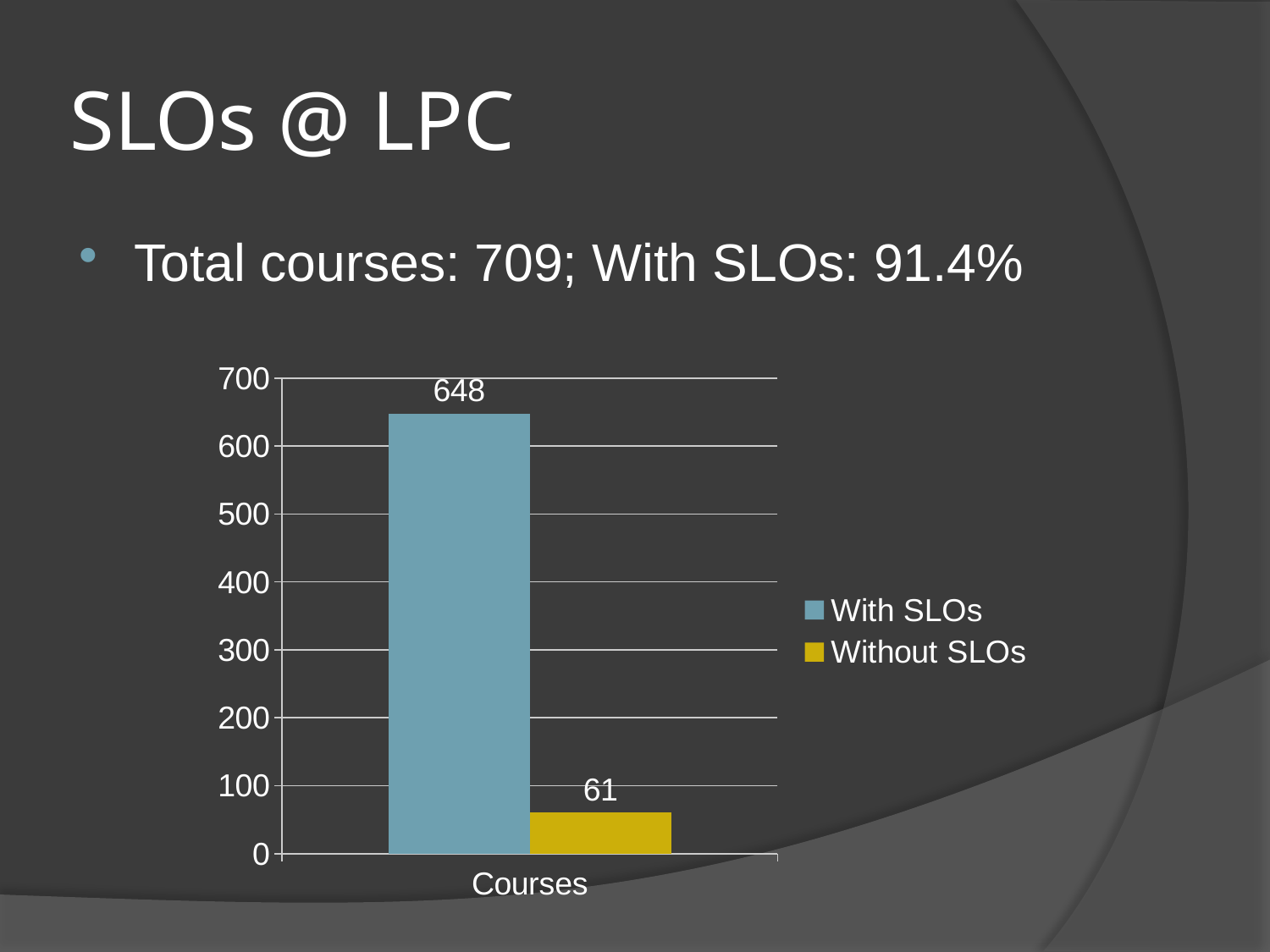
Which series has the lowest value on the chart? Without SLOs Is the value for With SLOs greater or less than 600? greater What is the label of the category on the x axis? Courses What is the value for Without SLOs in the Courses category? 61 What is the difference between the With SLOs and Without SLOs values? 587 What colour is the bar for Without SLOs? yellow How many series does the legend list? 2 Which series has the higher value for Courses, With SLOs or Without SLOs? With SLOs What kind of chart is shown on the slide? bar chart How many categories are shown on the x axis? 1 Is the value for Without SLOs greater or less than 100? less What is the value for With SLOs in the Courses category? 648